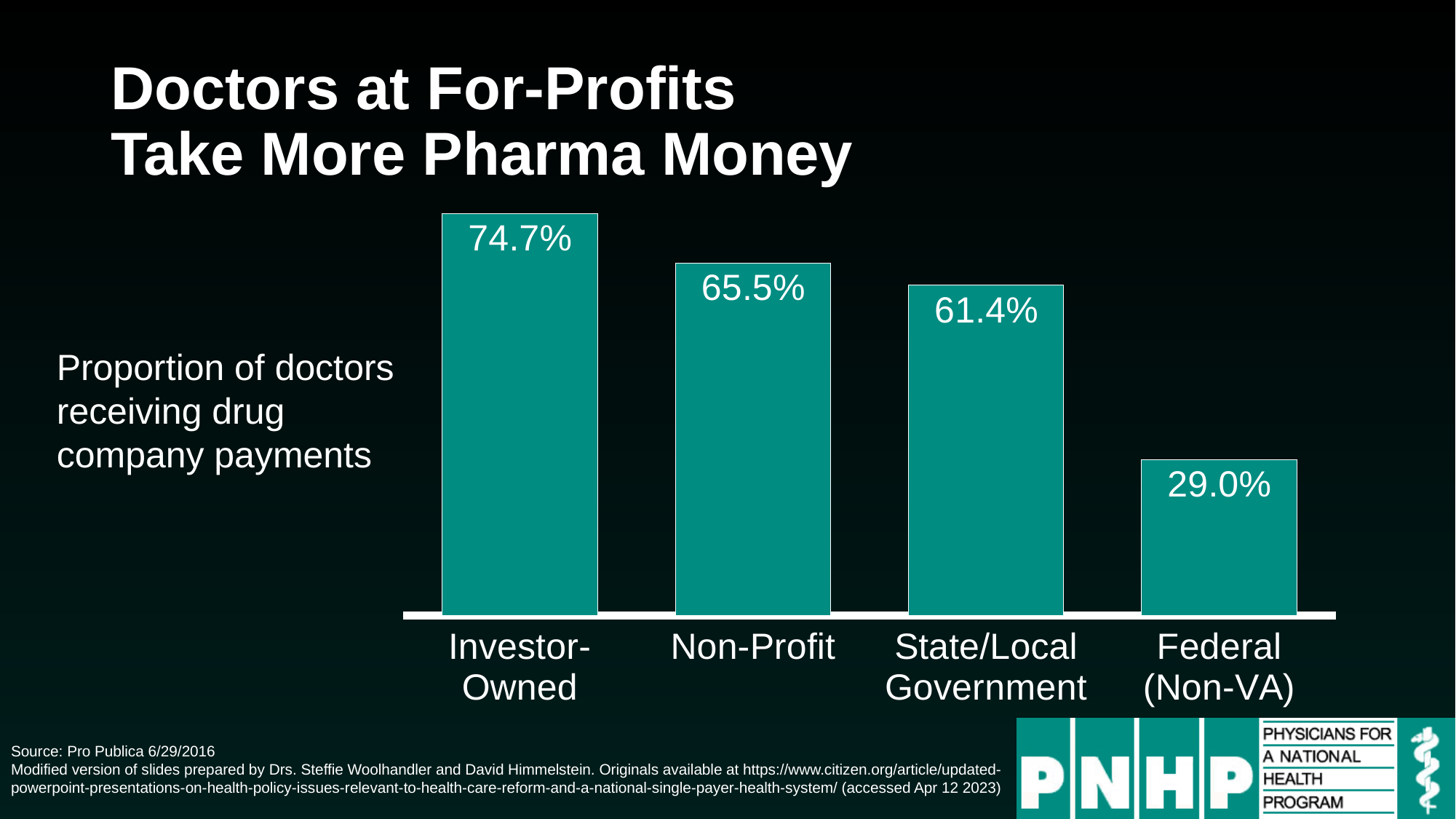
What proportion of doctors at Investor-Owned hospitals receive drug company payments? 74.7% Which category has the highest proportion of doctors receiving drug company payments? Investor-Owned What is the difference between the Non-Profit and State/Local Government values? 4.1% What is the value shown for Federal (Non-VA)? 29.0% What is the value shown for State/Local Government? 61.4% What is the value shown for Non-Profit? 65.5% Which category has the lowest proportion of doctors receiving drug company payments? Federal (Non-VA) Which is larger, the value for Non-Profit or the value for State/Local Government? Non-Profit What kind of chart is shown on the slide? Bar chart Do the values rise or fall moving from left to right across the categories? Fall How many categories are shown in the chart? 4 What is the difference between the Investor-Owned and Federal (Non-VA) values? 45.7%